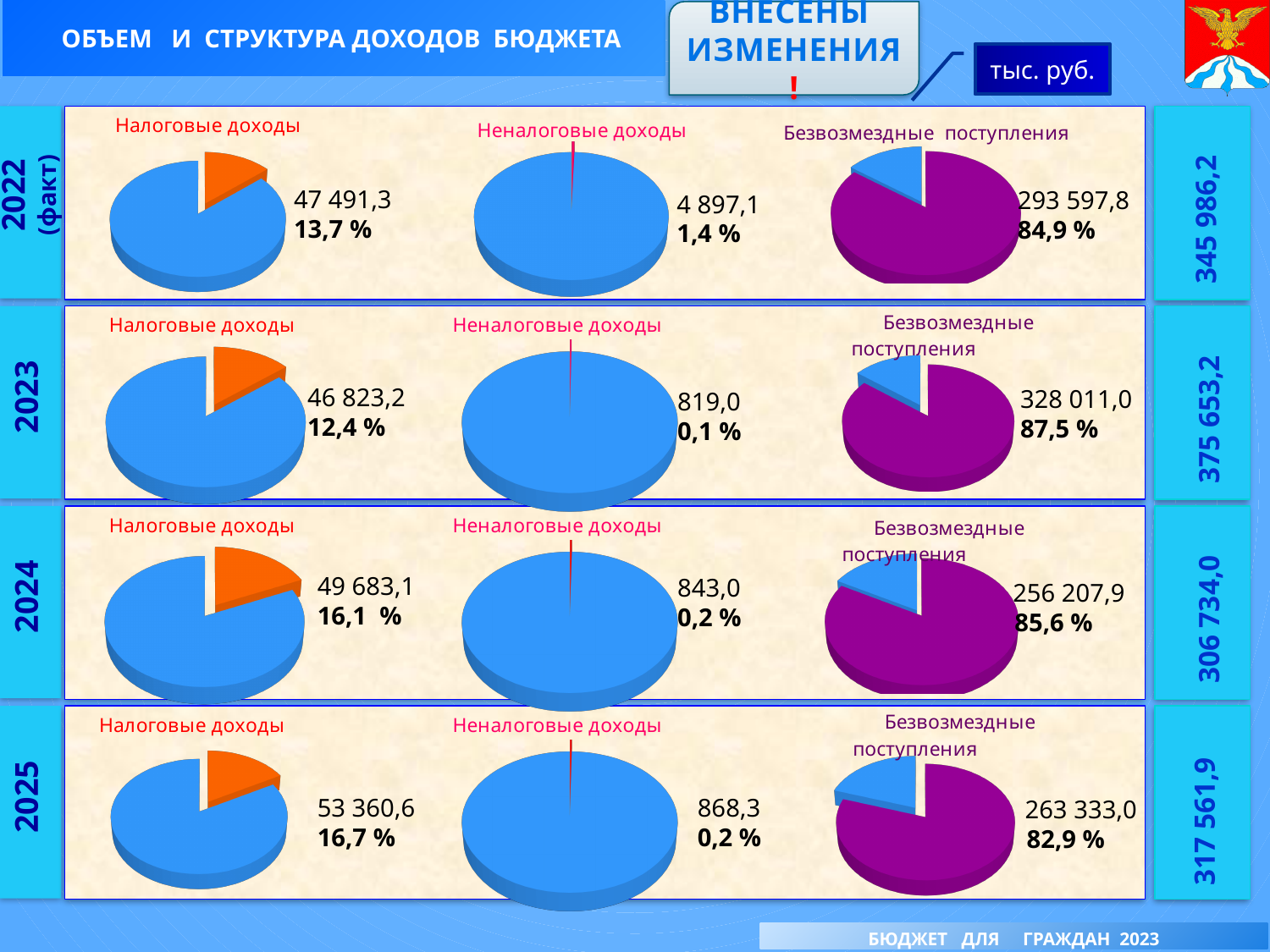
How many pie charts are shown on the slide? 12 In the 2022 (факт) row, what share does the highlighted slice of the Безвозмездные поступления pie chart represent? 84,9 % Which year's Неналоговые доходы pie chart shows the lowest value? 2023 What kind of charts are used on this slide? Pie charts In the 2024 row, what value is shown on the Безвозмездные поступления pie chart? 256 207,9 In the 2023 row, what percentage is shown on the Налоговые доходы pie chart? 12,4 % In the 2023 row, what value is shown on the Неналоговые доходы pie chart? 819,0 In the 2025 row, what value is shown on the Налоговые доходы pie chart? 53 360,6 In the 2022 (факт) row, what value is shown on the Налоговые доходы pie chart? 47 491,3 In the 2025 row, what percentage is shown on the Безвозмездные поступления pie chart? 82,9 % Which year's Налоговые доходы pie chart shows the highest value? 2025 Which is larger: the Безвозмездные поступления value for 2023 or for 2024? 2023